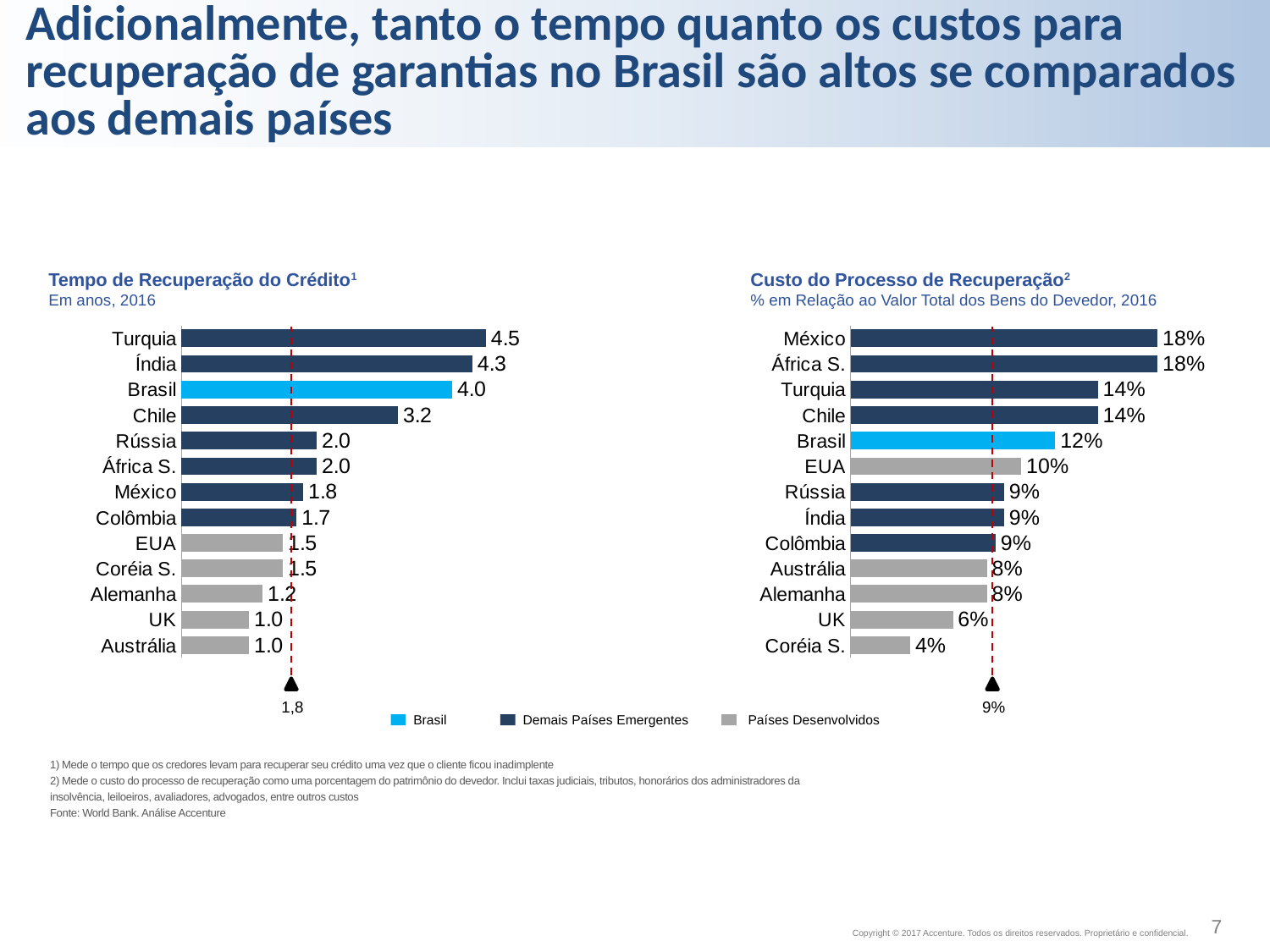
How many entries does the legend on the slide list? 3 In the 'Custo do Processo de Recuperação' chart, which is larger, the value for EUA or the value for UK? EUA In the 'Custo do Processo de Recuperação' chart, what is the value for Brasil? 12% In the 'Custo do Processo de Recuperação' chart, which country has the lowest value? Coréia S. In the 'Tempo de Recuperação do Crédito' chart, what is the value for Chile? 3.2 In the 'Custo do Processo de Recuperação' chart, what is the value for Turquia? 14% What kind of chart is the 'Tempo de Recuperação do Crédito' chart? Bar chart In the 'Custo do Processo de Recuperação' chart, what is the difference between México and Brasil? 6% In the 'Tempo de Recuperação do Crédito' chart, what is the difference between Turquia and Brasil? 0.5 In the 'Tempo de Recuperação do Crédito' chart, how many countries are shown? 13 In the 'Tempo de Recuperação do Crédito' chart, what is the value for Brasil? 4.0 In the 'Tempo de Recuperação do Crédito' chart, which country has the highest value? Turquia